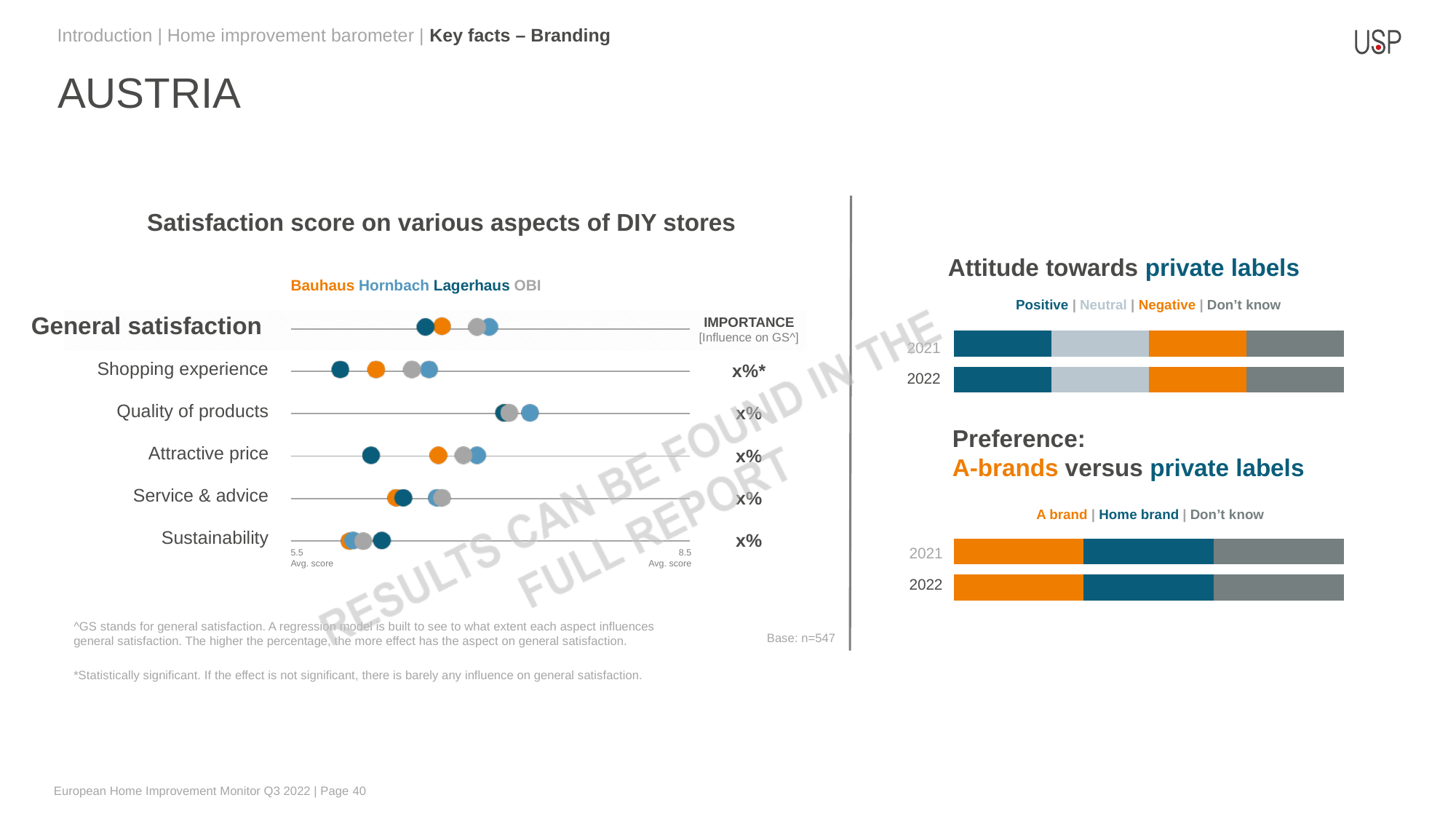
In the 'Satisfaction score on various aspects of DIY stores' chart, which brand has the highest score for Attractive price? Hornbach What kind of chart is 'Attitude towards private labels'? Stacked bar chart What are the legend entries of the 'Preference: A-brands versus private labels' chart? A brand, Home brand, Don't know How many DIY store brands does the legend of the 'Satisfaction score on various aspects of DIY stores' chart list? 4 In the 'Satisfaction score on various aspects of DIY stores' chart, which brand has the highest score for Quality of products? Hornbach In the 'Satisfaction score on various aspects of DIY stores' chart, which brand has the lowest score for Shopping experience? Lagerhaus In the 'Satisfaction score on various aspects of DIY stores' chart, which brand has the highest score for Sustainability? Lagerhaus What kind of chart is 'Satisfaction score on various aspects of DIY stores'? Dot plot How many years are shown in the 'Preference: A-brands versus private labels' chart? 2 How many series does the legend of the 'Attitude towards private labels' chart list? 4 In the 'Satisfaction score on various aspects of DIY stores' chart, for Attractive price, is the score for Lagerhaus higher or lower than the score for Bauhaus? Lower How many aspects are listed in the 'Satisfaction score on various aspects of DIY stores' chart? 6